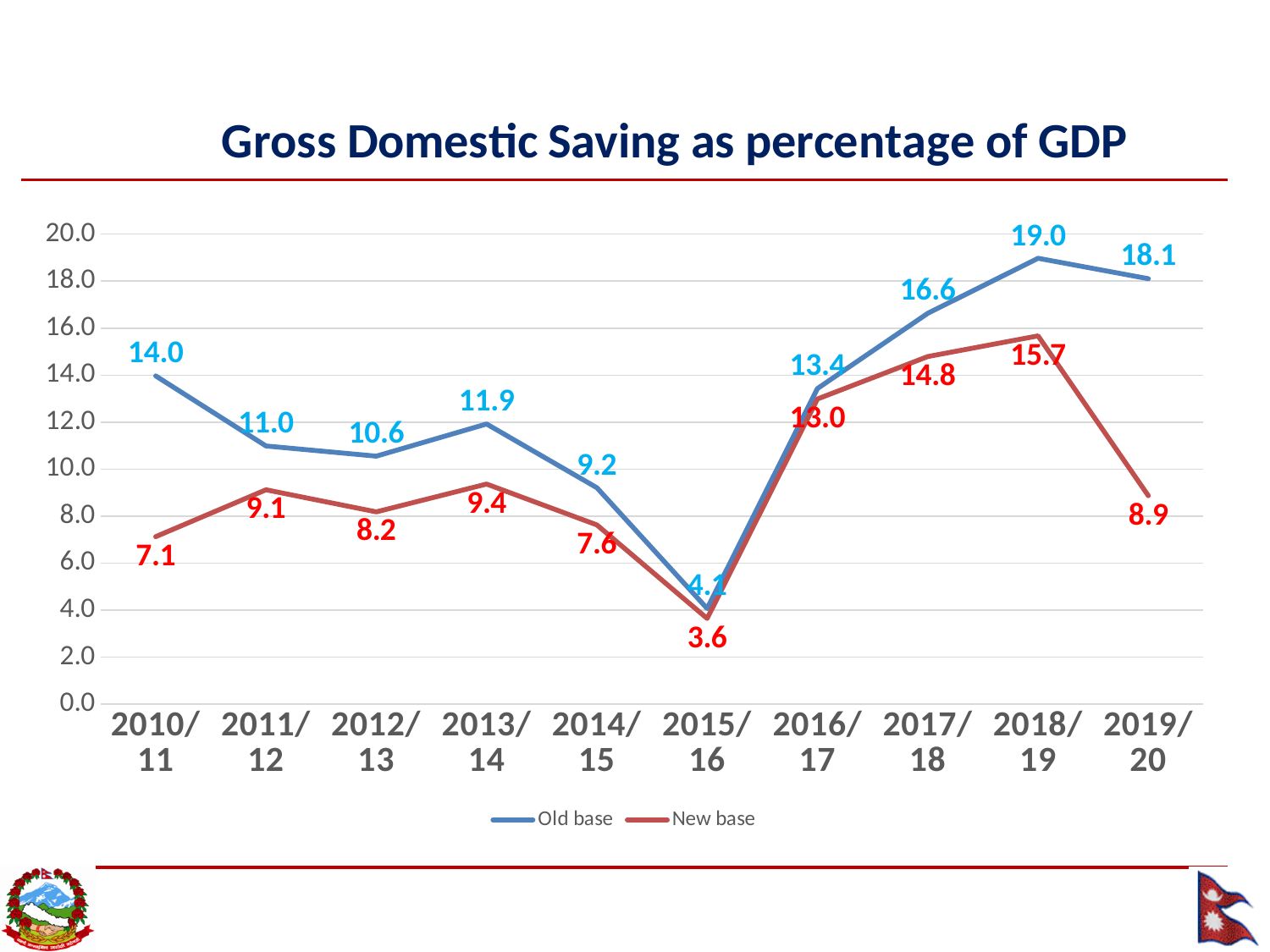
What is the New base value for 2019/20? 8.9 What is the difference between the Old base and New base values in 2019/20? 9.2 Does the Old base series rise or fall from 2015/16 to 2018/19? Rise Which is larger in 2010/11, the Old base value or the New base value? Old base What is the title of the chart? Gross Domestic Saving as percentage of GDP How many years are shown on the x axis? 10 What is the New base value for 2015/16? 3.6 How many series does the legend list? 2 What is the Old base value for 2018/19? 19.0 Which year has the highest Old base value? 2018/19 Which year has the lowest New base value? 2015/16 What kind of chart is shown on the slide? Line chart